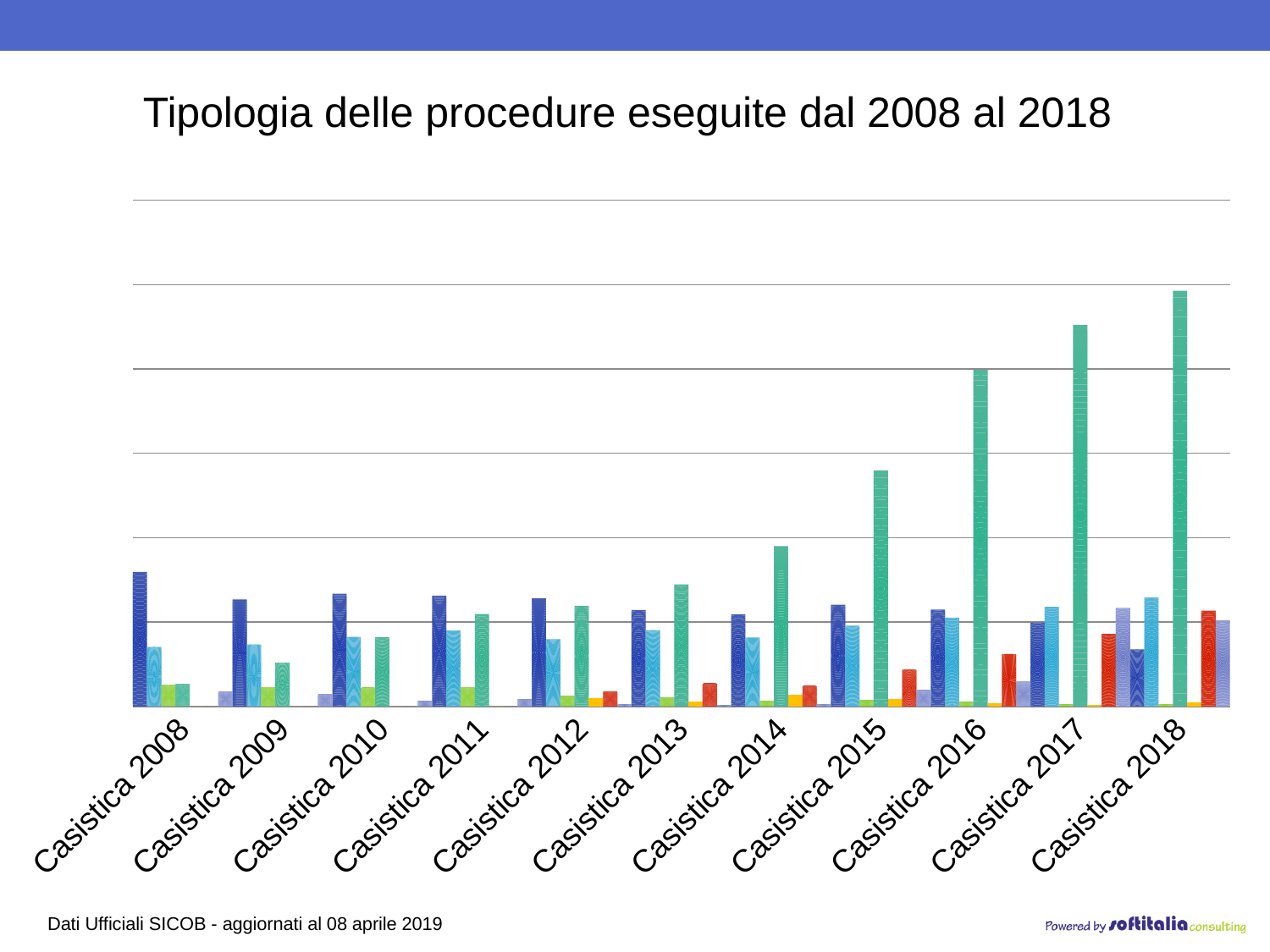
Which category has the tallest dark blue bar? Casistica 2008 Is the green bar larger for Casistica 2017 or for Casistica 2018? Casistica 2018 Do the green bars rise or fall from Casistica 2013 to Casistica 2018? Rise Is the green bar larger for Casistica 2014 or for Casistica 2016? Casistica 2016 Which category contains the tallest bar in the chart? Casistica 2018 Is the green bar larger for Casistica 2008 or for Casistica 2009? Casistica 2009 What is the label of the first category on the x axis? Casistica 2008 How many categories are shown along the x axis of the chart? 11 What is the title of the chart on the slide? Tipologia delle procedure eseguite dal 2008 al 2018 What kind of chart is shown on the slide? Bar chart